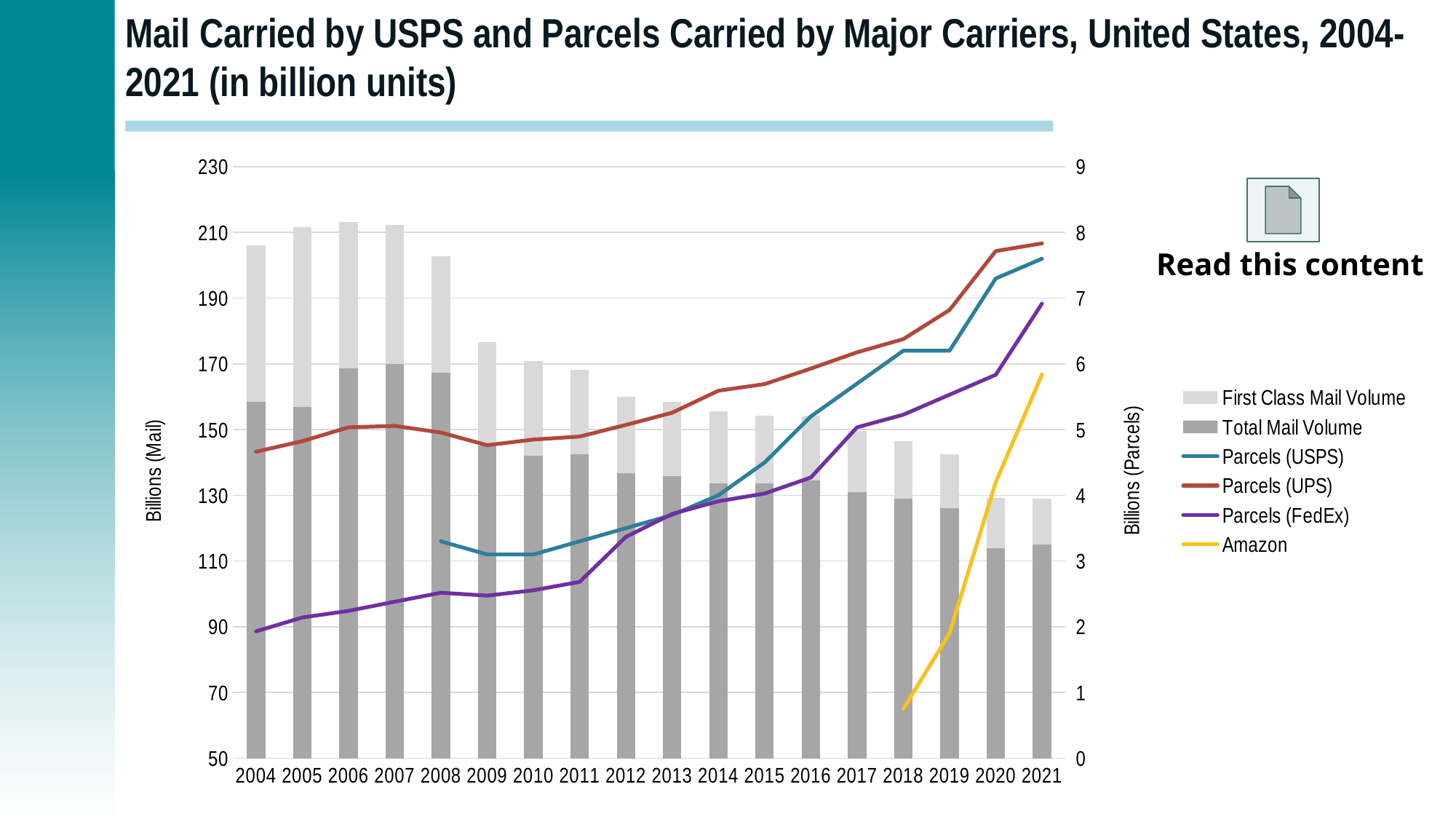
How many series does the legend list? 6 Is the value for Amazon in 2018 greater or less than 1? less In 2021, which is larger: Parcels (UPS) or Parcels (FedEx)? Parcels (UPS) Is the value for Parcels (USPS) in 2009 greater or less than 4? less In 2012, which is larger: Parcels (USPS) or Parcels (UPS)? Parcels (UPS) Do the Total Mail Volume bars generally rise or fall from 2007 to 2021? Fall Does the Parcels (UPS) line generally rise or fall from 2009 to 2021? Rise Is the value for Parcels (UPS) in 2021 greater or less than 7? greater What kind of chart is shown on the slide? A combination bar and line chart Which year has the lowest value for Parcels (FedEx)? 2004 How many years are shown along the x axis? 18